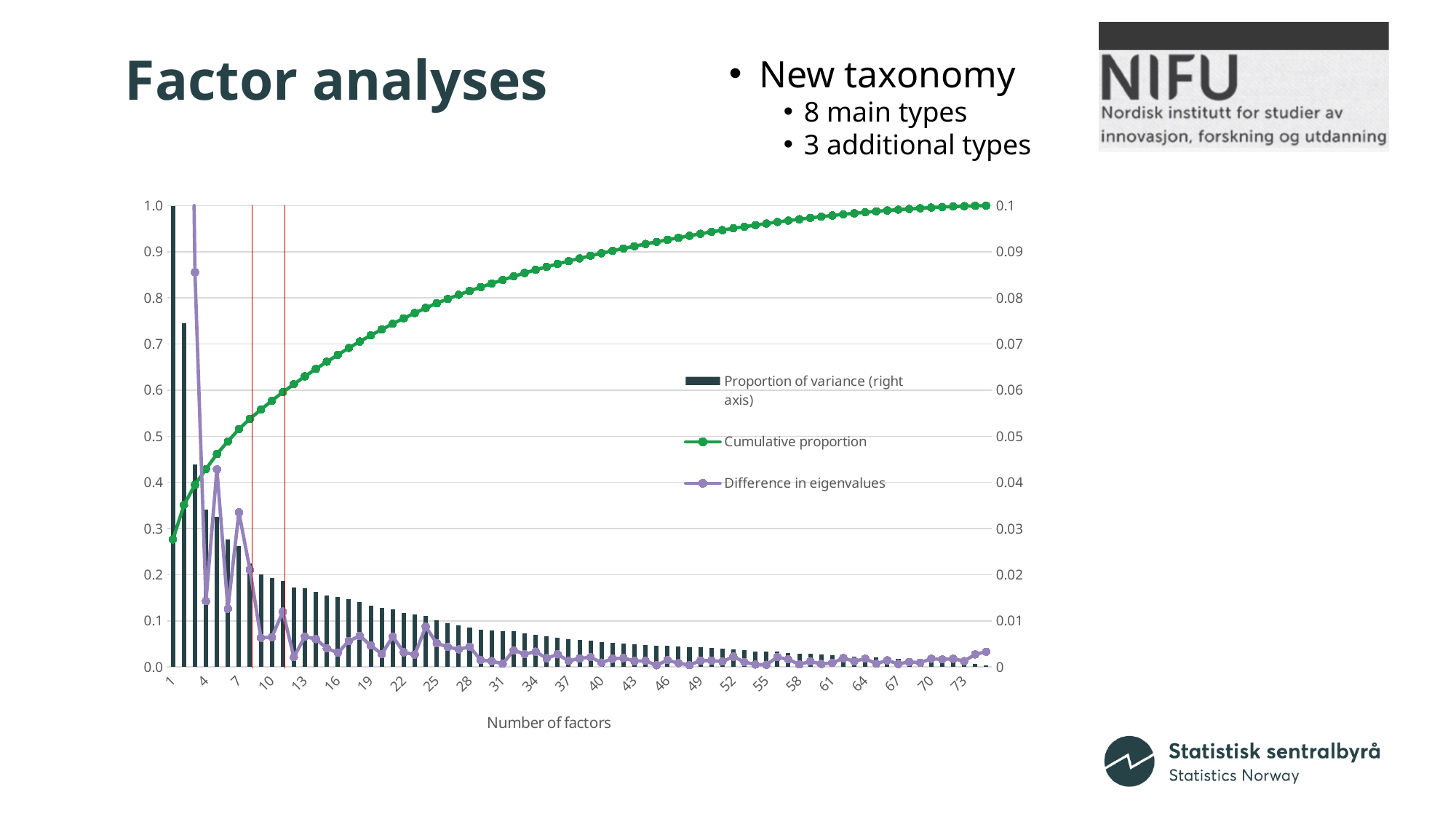
Do the proportion of variance bars rise or fall as the number of factors increases? Fall Which is larger, the cumulative proportion at 40 factors or at 10 factors? 40 factors Is the difference in eigenvalues at 4 factors greater or less than 0.2? less Which series is plotted on the right axis according to the legend? Proportion of variance What kind of chart is shown on the slide? A combined bar and line chart Is the proportion of variance for 1 factor greater or less than 0.05 on the right axis? greater Is the cumulative proportion at 10 factors greater or less than 0.5? greater Which number of factors has the highest proportion of variance? 1 Does the cumulative proportion rise or fall as the number of factors increases? Rises How many series does the chart legend list? 3 What is the title of the x axis? Number of factors